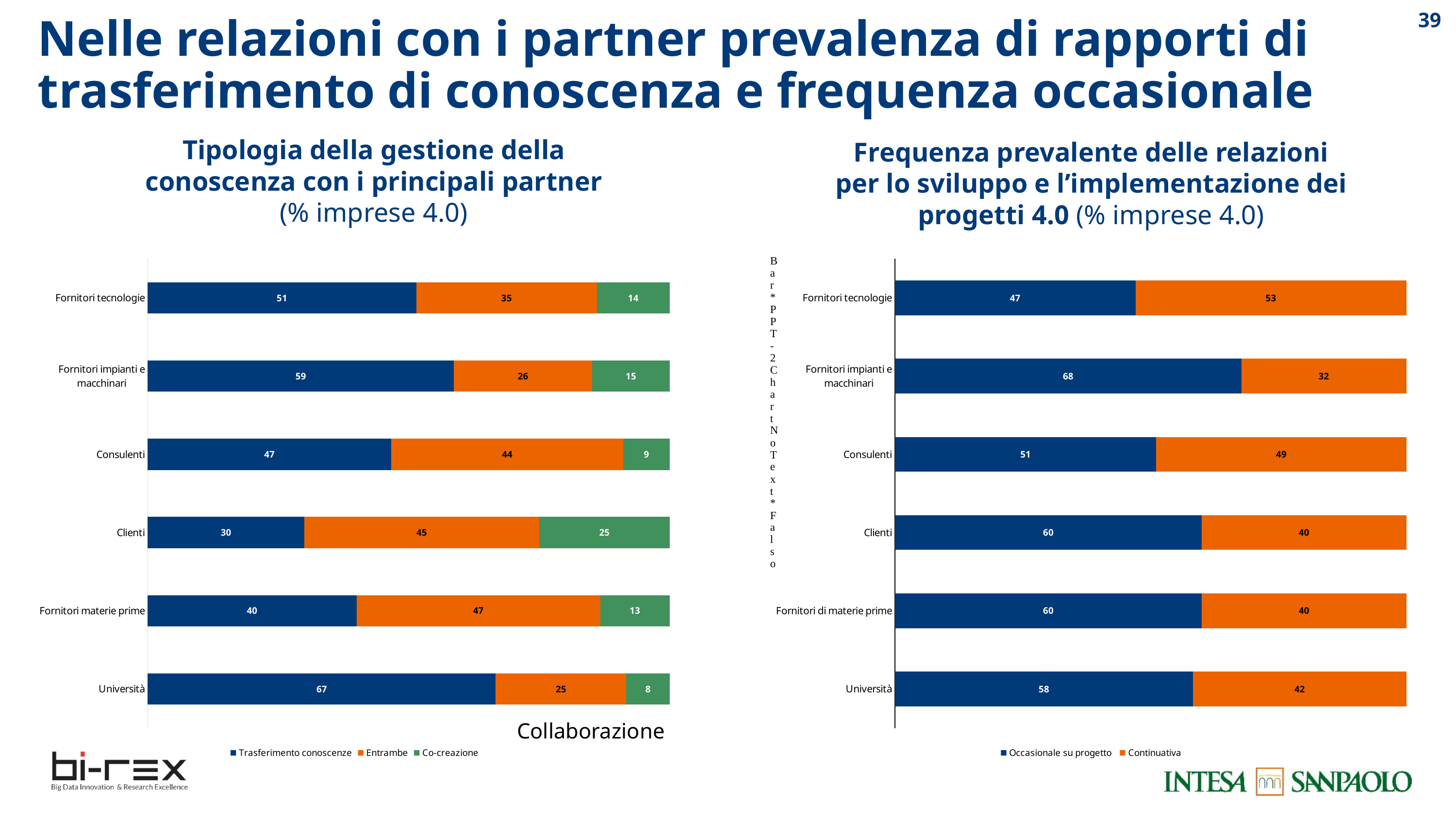
What kind of chart is the right chart (Frequenza prevalente delle relazioni per lo sviluppo e l'implementazione dei progetti 4.0)? Stacked bar chart In the right chart (Frequenza prevalente delle relazioni per lo sviluppo e l'implementazione dei progetti 4.0), what is the Occasionale su progetto value for Fornitori impianti e macchinari? 68 In the left chart (Tipologia della gestione della conoscenza con i principali partner), what is the difference between the Entrambe values for Consulenti and Fornitori tecnologie? 9 In the left chart (Tipologia della gestione della conoscenza con i principali partner), what is the value of Co-creazione for Clienti? 25 In the right chart (Frequenza prevalente delle relazioni per lo sviluppo e l'implementazione dei progetti 4.0), which category has the highest Continuativa value? Fornitori tecnologie In the left chart (Tipologia della gestione della conoscenza con i principali partner), what is the value of Trasferimento conoscenze for Università? 67 In the right chart (Frequenza prevalente delle relazioni per lo sviluppo e l'implementazione dei progetti 4.0), what is the difference between the Occasionale su progetto and Continuativa values for Università? 16 In the left chart (Tipologia della gestione della conoscenza con i principali partner), how many series does the legend list? 3 In the left chart (Tipologia della gestione della conoscenza con i principali partner), which category has the highest Trasferimento conoscenze value? Università In the left chart (Tipologia della gestione della conoscenza con i principali partner), which category has the lowest Co-creazione value? Università In the right chart (Frequenza prevalente delle relazioni per lo sviluppo e l'implementazione dei progetti 4.0), how many categories are shown? 6 In the right chart (Frequenza prevalente delle relazioni per lo sviluppo e l'implementazione dei progetti 4.0), is the Occasionale su progetto value larger for Consulenti or for Università? Università